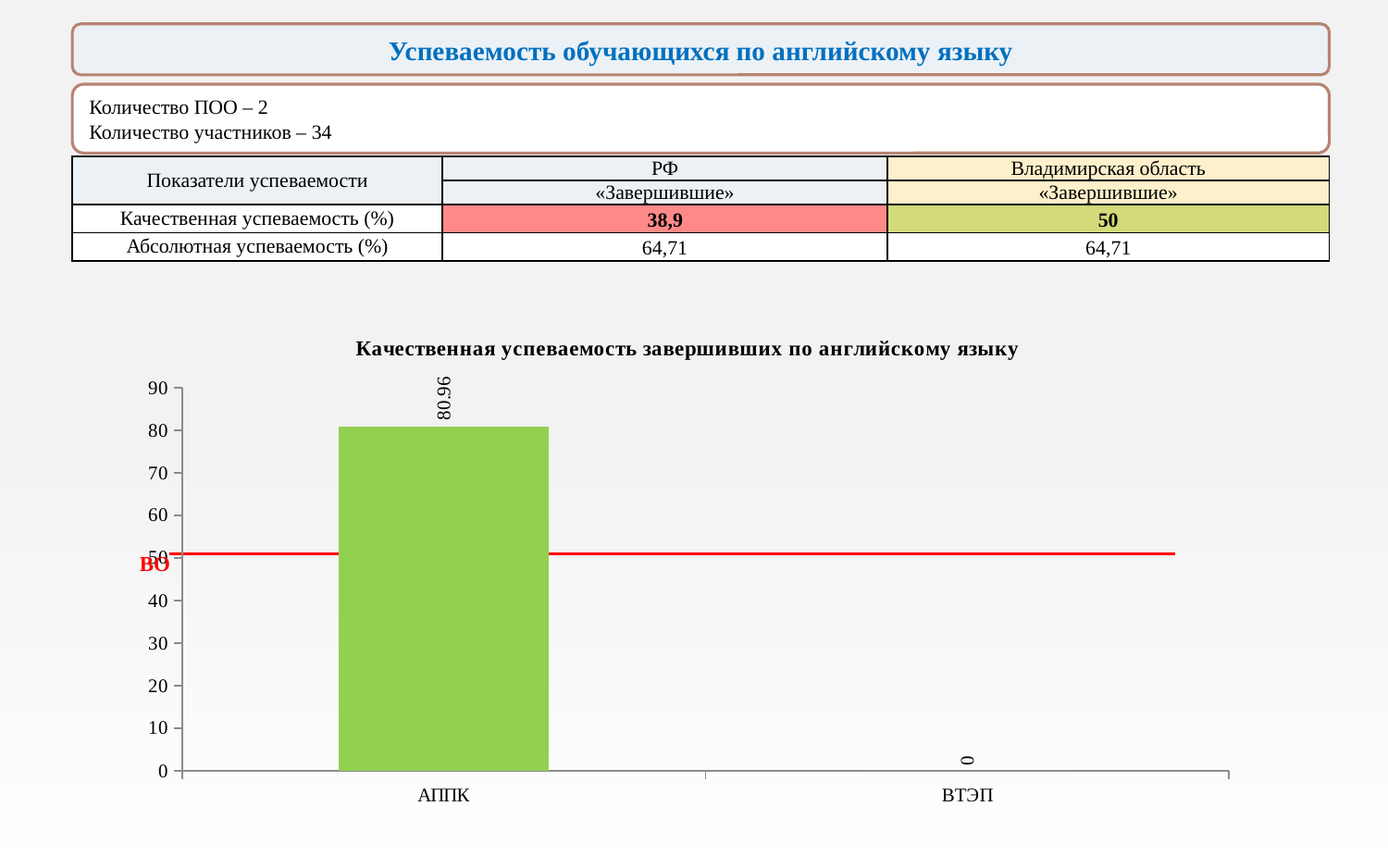
At what value on the y axis is the red horizontal line labelled ВО drawn? 50 How many categories are shown on the x axis of the chart? 2 What kind of chart is shown on the slide? bar chart What is the value for АППК in the chart? 80.96 What is the title of the chart? Качественная успеваемость завершивших по английскому языку What is the difference between the values for АППК and ВТЭП? 80.96 Which is larger, the value for АППК or the value for ВТЭП? АППК Which category has the lowest value in the chart? ВТЭП What is the value for ВТЭП in the chart? 0 Is the value for АППК greater or less than 50? greater What is the maximum value shown on the y axis of the chart? 90 Which category has the highest value in the chart? АППК